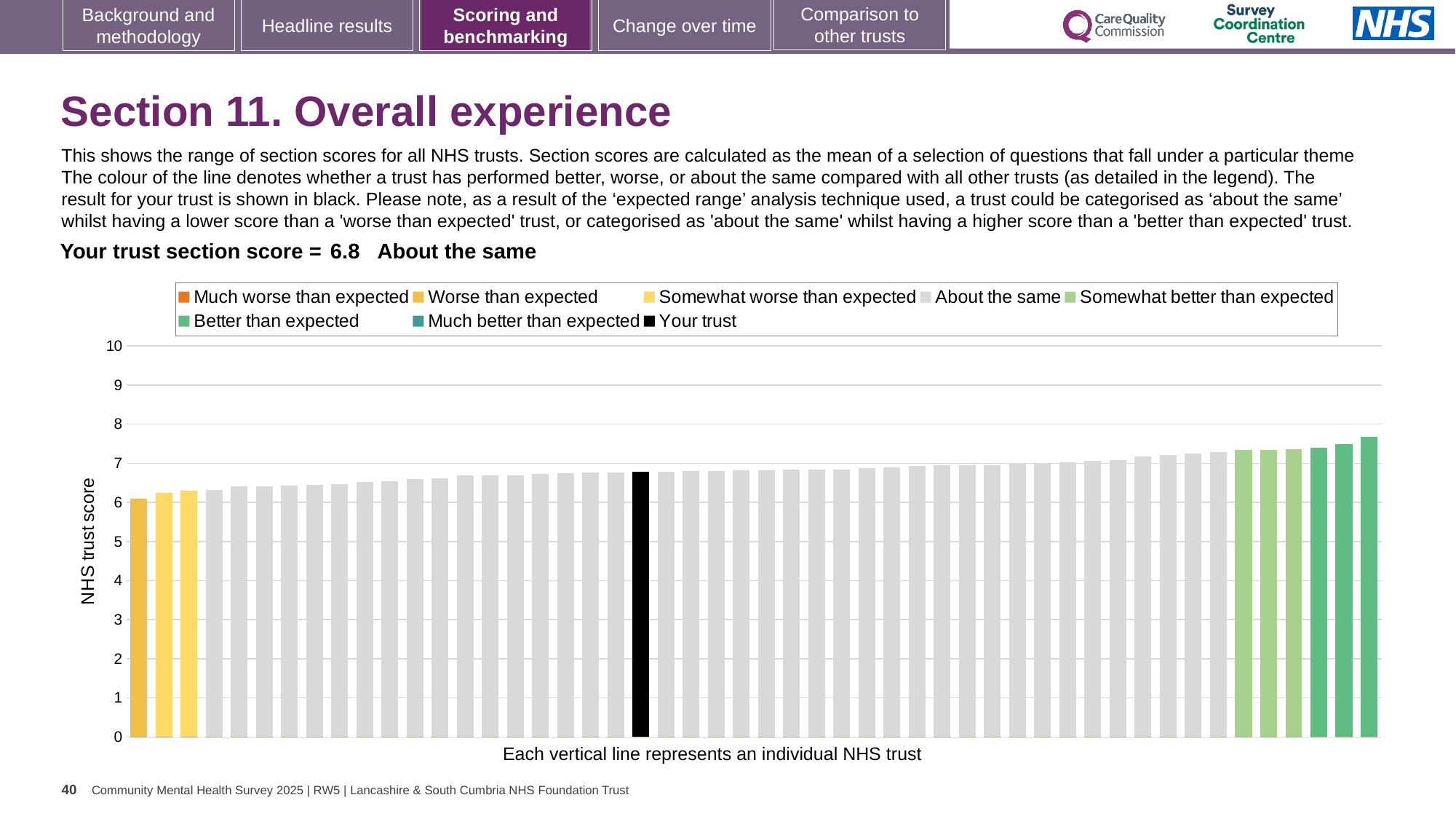
What is the label on the vertical axis of the chart? NHS trust score How many entries does the chart legend list? 8 What kind of chart is shown on the slide? Bar chart Is the value for your trust greater or less than 5? greater Which category is your trust placed in for this section? About the same What colour is the bar representing your trust? Black Is the value for the shortest bar greater or less than 7? less Is the value for the tallest bar greater or less than 7? greater Do the bar values rise or fall from left to right along the x axis? Rise What is the section score for your trust shown on the slide? 6.8